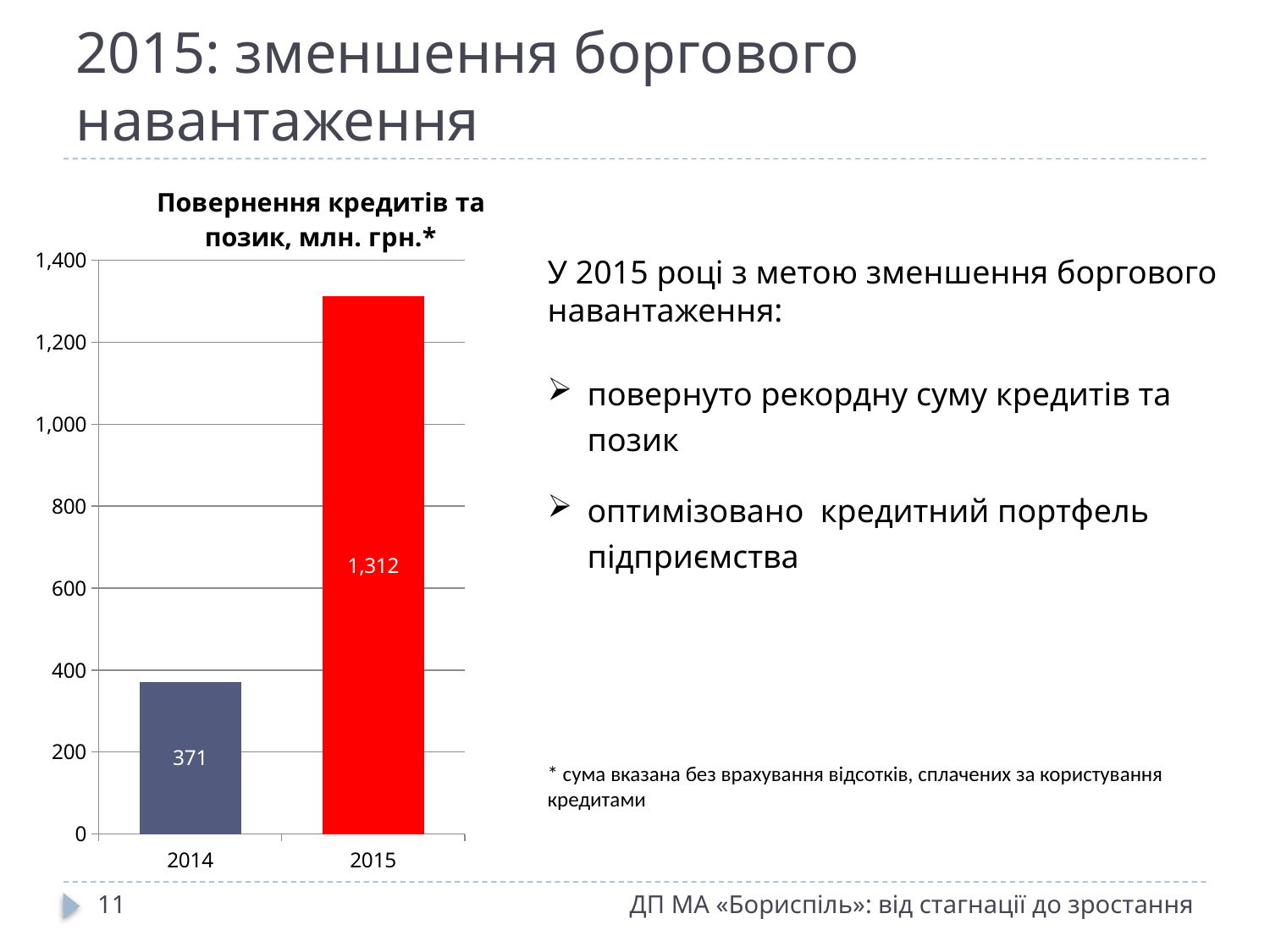
How many years are shown on the x axis of the chart? 2 What is the value for 2014 in the chart? 371 What is the difference between the 2015 and 2014 values? 941 Is the value for 2015 greater or less than 1,200? greater Which year has the lower value in the chart? 2014 What kind of chart is shown on the slide? Bar chart Is the value for 2015 larger than the value for 2014? Yes What is the title of the chart? Повернення кредитів та позик, млн. грн.* Do the values rise or fall from 2014 to 2015? Rise What is the value for 2015 in the chart? 1,312 Which year has the higher value in the chart? 2015 Is the value for 2014 greater or less than 400? less